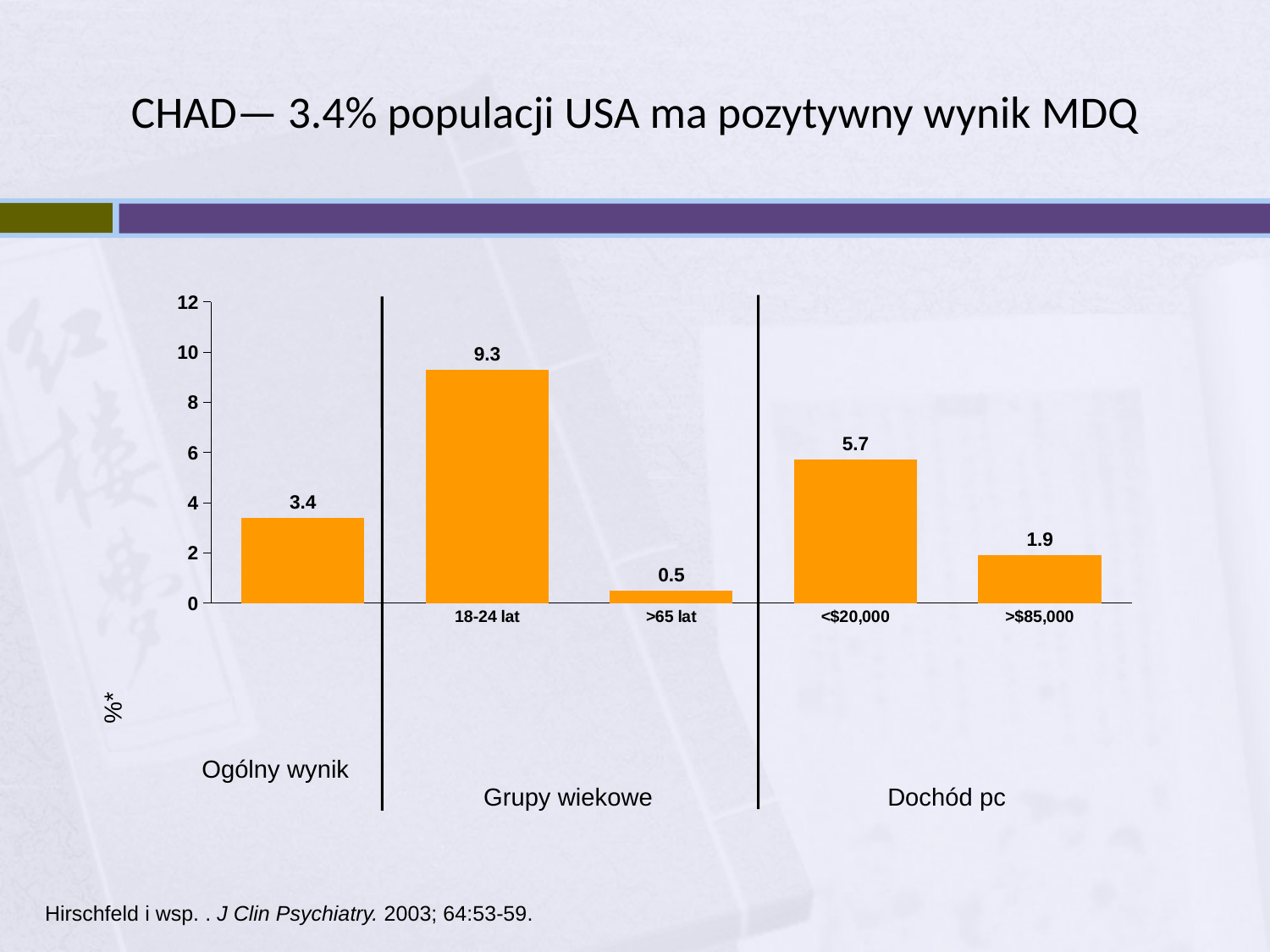
Which category has the highest value? 18-24 lat What is the difference between the values for 18-24 lat and >65 lat? 8.8 What is the difference between the values for <$20,000 and >$85,000? 3.8 What kind of chart is shown on the slide? Bar chart What is the value for the 18-24 lat age group? 9.3 How many bars are plotted in the chart? 5 Which category has the lowest value? >65 lat What is the value of the Ogólny wynik (overall) bar? 3.4 What is the value for the >65 lat age group? 0.5 What is the value for the >$85,000 income group? 1.9 Which is larger, the value for <$20,000 or the value for 18-24 lat? 18-24 lat What is the value for the <$20,000 income group? 5.7